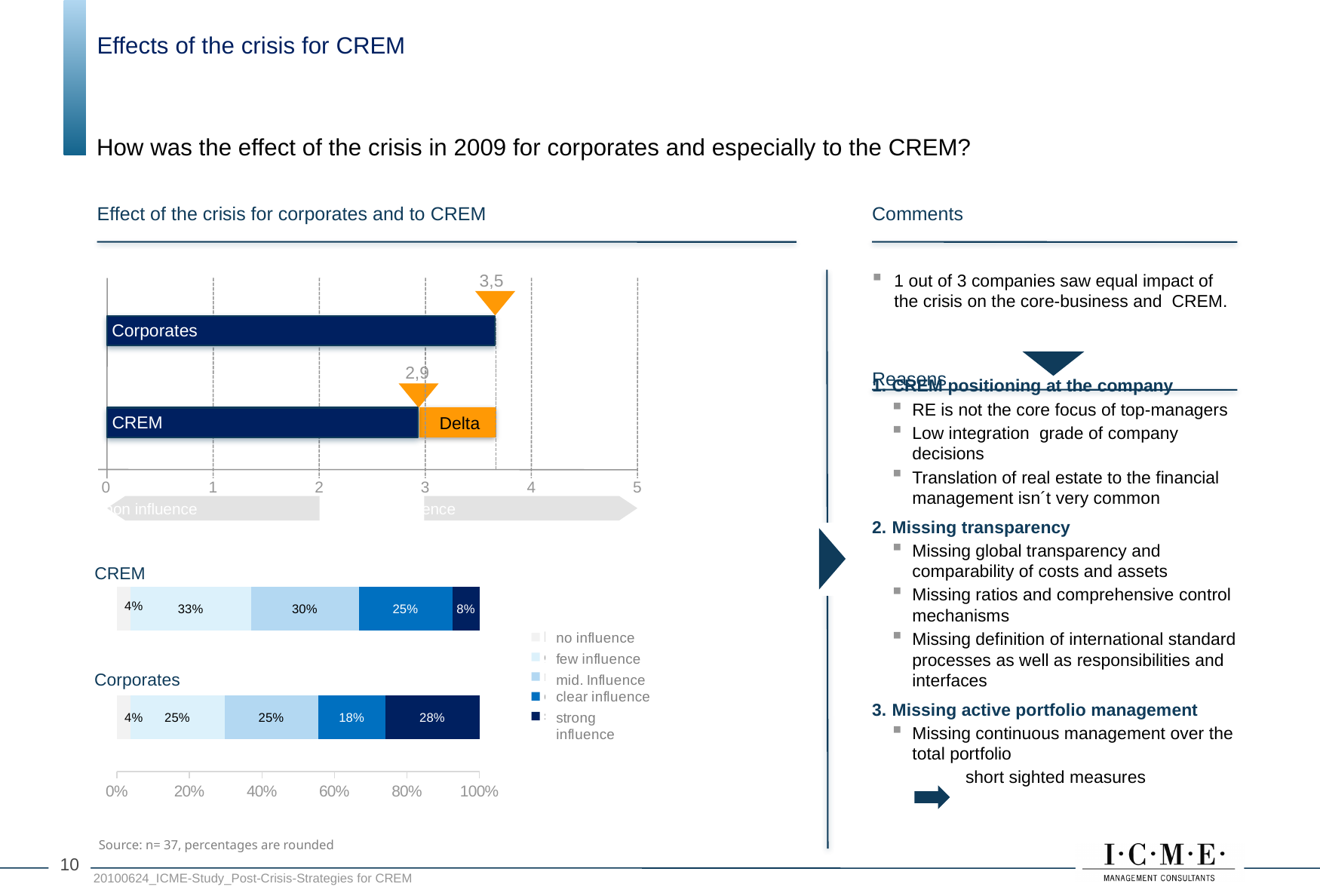
In the bottom stacked bar chart, what percentage of Corporates responses fall under 'strong influence'? 28% How many series does the legend of the bottom stacked bar chart list? 5 In the bottom stacked bar chart, what percentage of CREM responses fall under 'few influence'? 33% In the top chart, what is the value shown for CREM? 2,9 In the bottom stacked bar chart, what percentage of CREM responses fall under 'strong influence'? 8% What kind of chart is the bottom chart on the slide? Stacked bar chart In the bottom stacked bar chart, what is the difference between the 'strong influence' share for Corporates and for CREM? 20% In the bottom stacked bar chart, which is larger: the 'clear influence' share for CREM or for Corporates? CREM In the top chart, which category has the higher value, Corporates or CREM? Corporates In the top chart, what is the value shown for Corporates? 3,5 In the top chart, what is the difference between the Corporates value and the CREM value? 0,6 In the top chart, what label is printed on the orange segment of the CREM bar? Delta